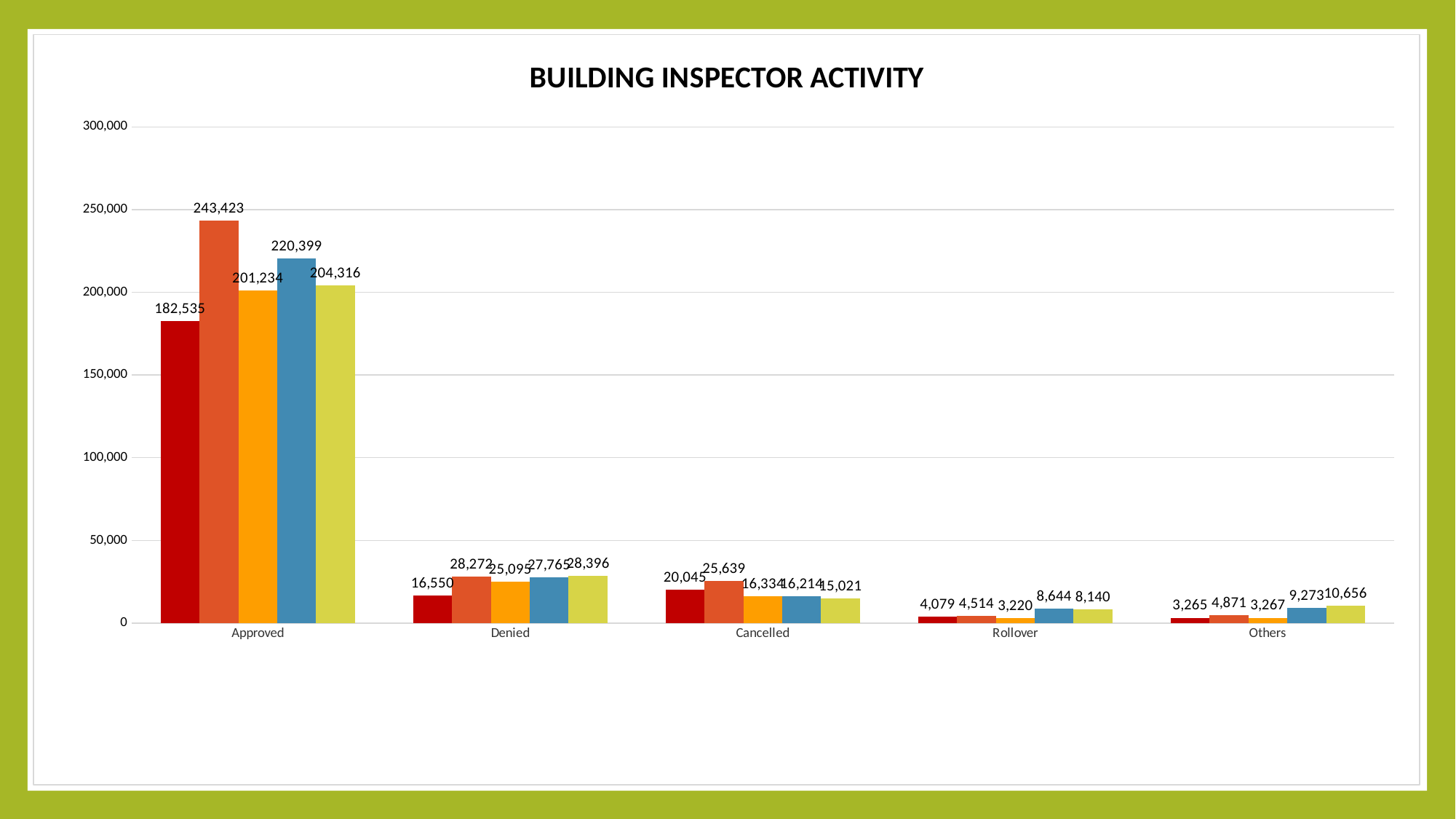
What is the difference between the orange-red (second) bar and the dark red (first) bar for Approved? 60,888 What is the value of the yellow-green (last) bar for Others? 10,656 What is the value of the orange-red (second) bar for Approved? 243,423 How many categories are shown on the x axis? 5 What is the value of the blue (fourth) bar for Rollover? 8,644 What is the value of the dark red (first) bar for Approved? 182,535 How many bars are plotted for each category? 5 Which category has the highest values overall? Approved Which bar is the tallest in the Approved category? the orange-red (second) bar Is the value of the blue (fourth) bar for Approved greater or less than 200,000? greater What is the title of the chart? BUILDING INSPECTOR ACTIVITY What kind of chart is shown on the slide? bar chart